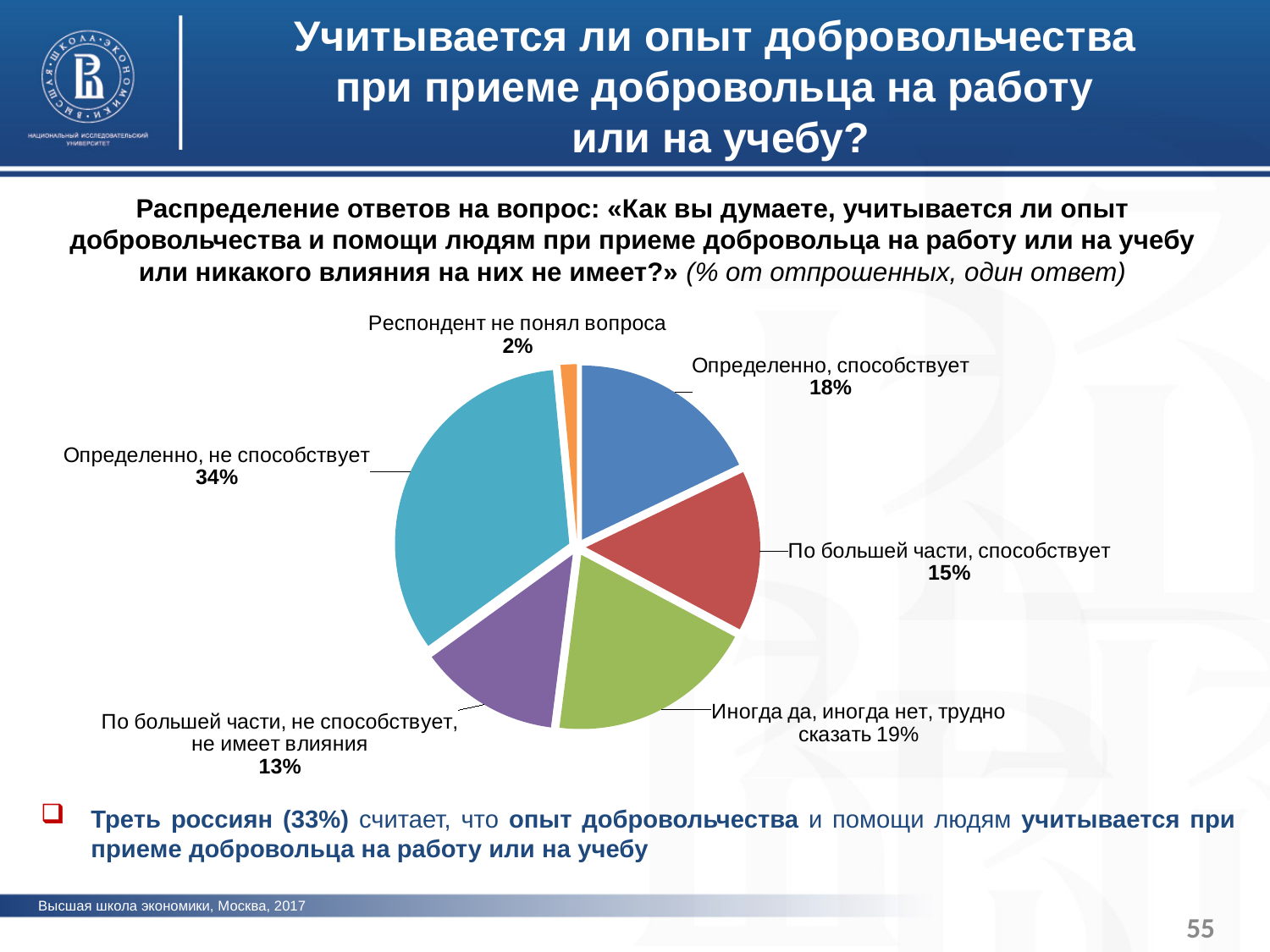
What share of respondents answered «Иногда да, иногда нет, трудно сказать»? 19% What is the difference in percentage points between «Определенно, не способствует» and «Определенно, способствует»? 16 What is the combined share of «Определенно, способствует» and «По большей части, способствует»? 33% What share of respondents answered «Определенно, способствует»? 18% What kind of chart is shown on the slide? pie chart What share of respondents answered «По большей части, способствует»? 15% What share of respondents answered «Определенно, не способствует»? 34% What share of respondents answered «По большей части, не способствует, не имеет влияния»? 13% Which is larger: the share for «Иногда да, иногда нет, трудно сказать» or the share for «По большей части, способствует»? Иногда да, иногда нет, трудно сказать Which answer option has the largest share of the pie? Определенно, не способствует How many slices does the pie chart have? 6 Which answer option has the smallest share of the pie? Респондент не понял вопроса